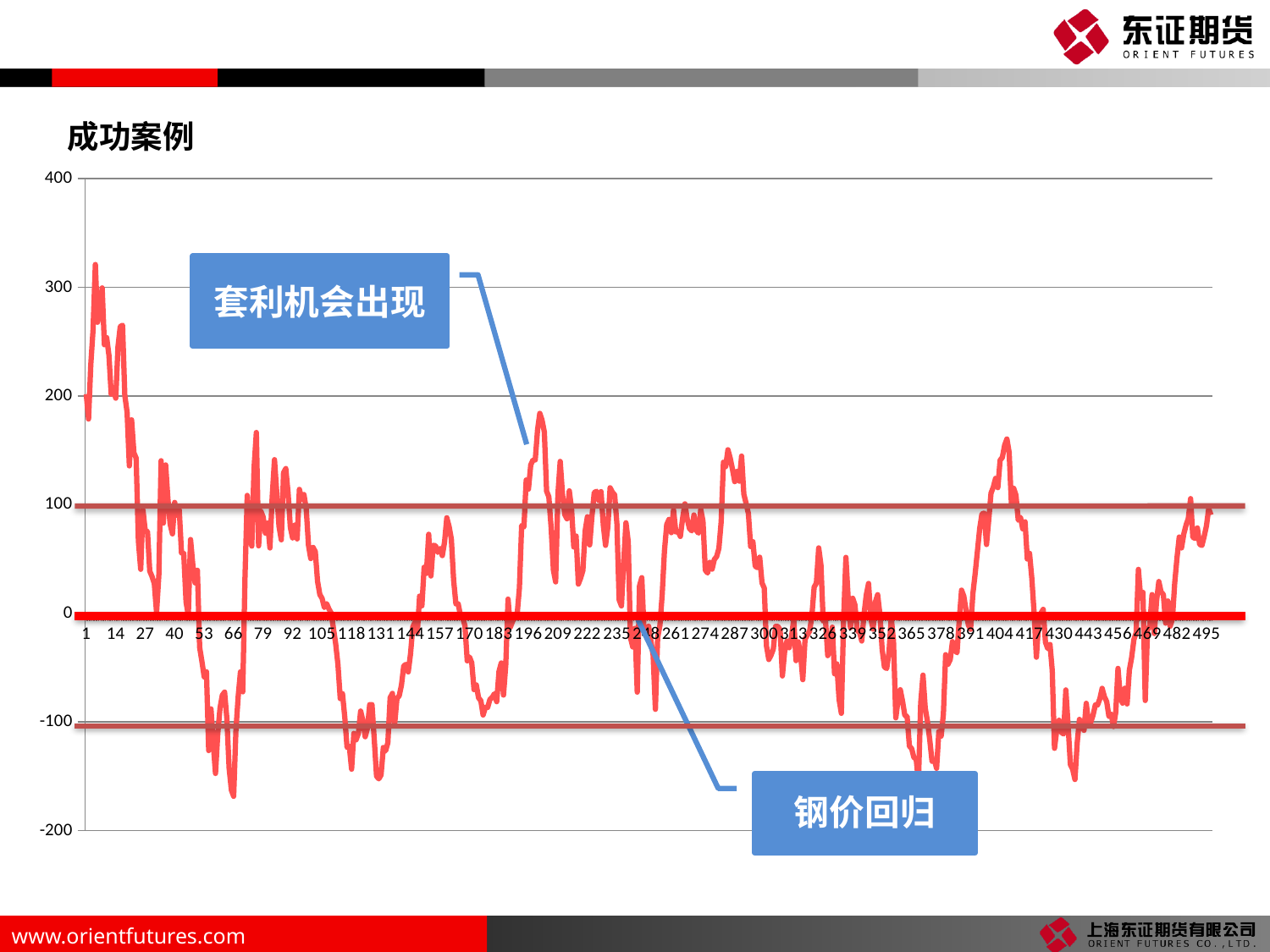
What is the last label shown on the horizontal axis? 495 Is the highest point of the line (near the start of the series) greater or less than 200? greater Does the line end higher or lower than it starts at x = 1? lower Is the peak of the line around x = 196–209 greater or less than 100? greater Is the lowest point of the line (around x = 66) greater or less than -100? less Which annotation label points to the peak of the line around x = 196? 套利机会出现 What kind of chart is shown on the slide? line chart What is the title of the slide containing the chart? 成功案例 Does the line rise or fall between x = 1 and x = 66? fall